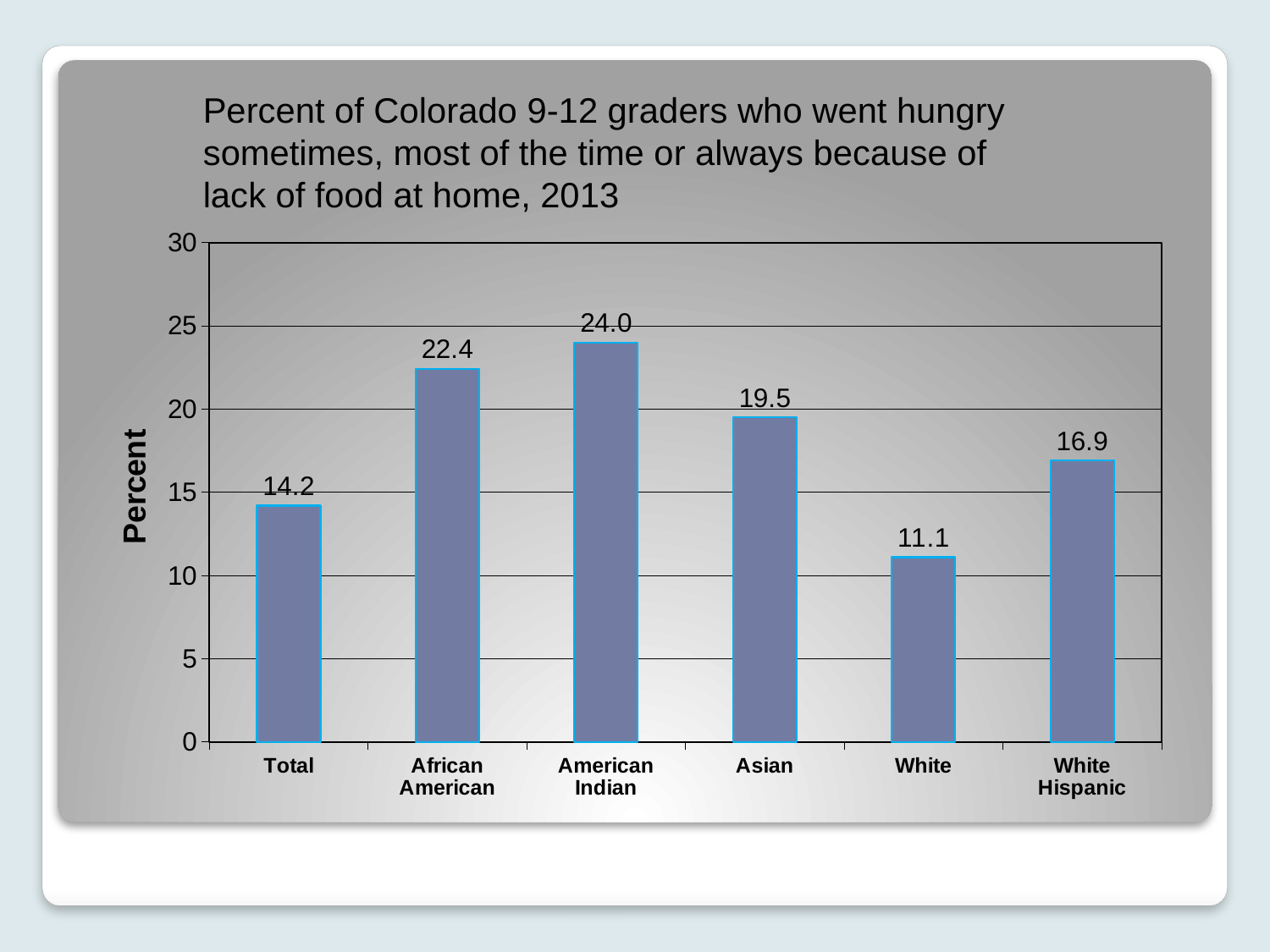
What is the difference between the values for American Indian and White? 12.9 What kind of chart is shown on the slide? bar chart Which is larger, the value for Asian or the value for White Hispanic? Asian Which category has the lowest value? White Is the value for White greater or less than 15? less What is the difference between the values for Asian and Total? 5.3 What is the value for Total? 14.2 Which category has the highest value? American Indian What is the label of the y axis? Percent How many categories are shown on the x axis? 6 What is the value for African American? 22.4 What is the value for White Hispanic? 16.9